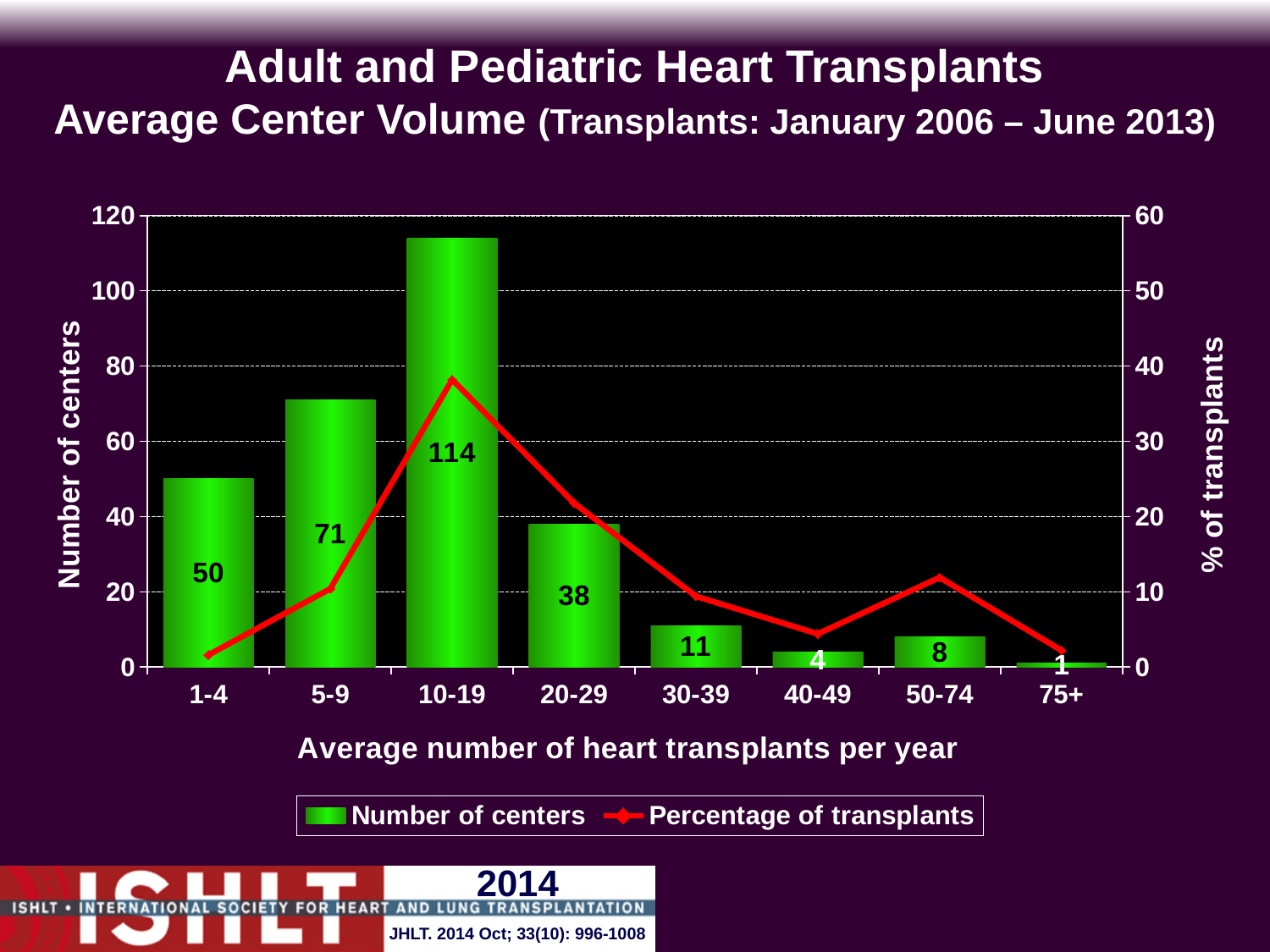
How many categories are shown on the x axis? 8 What is the number of centers for the 10-19 category? 114 How many series does the legend list? 2 What is the number of centers for the 5-9 category? 71 What is the number of centers for the 40-49 category? 4 Is the percentage of transplants for the 10-19 category greater or less than 30? greater Is the percentage of transplants for the 40-49 category greater or less than 10? less Which category has the highest number of centers? 10-19 Which category has the lowest number of centers? 75+ What is the difference in number of centers between the 10-19 and 5-9 categories? 43 Which has more centers, the 1-4 category or the 20-29 category? 1-4 What is the label of the right-hand vertical axis? % of transplants